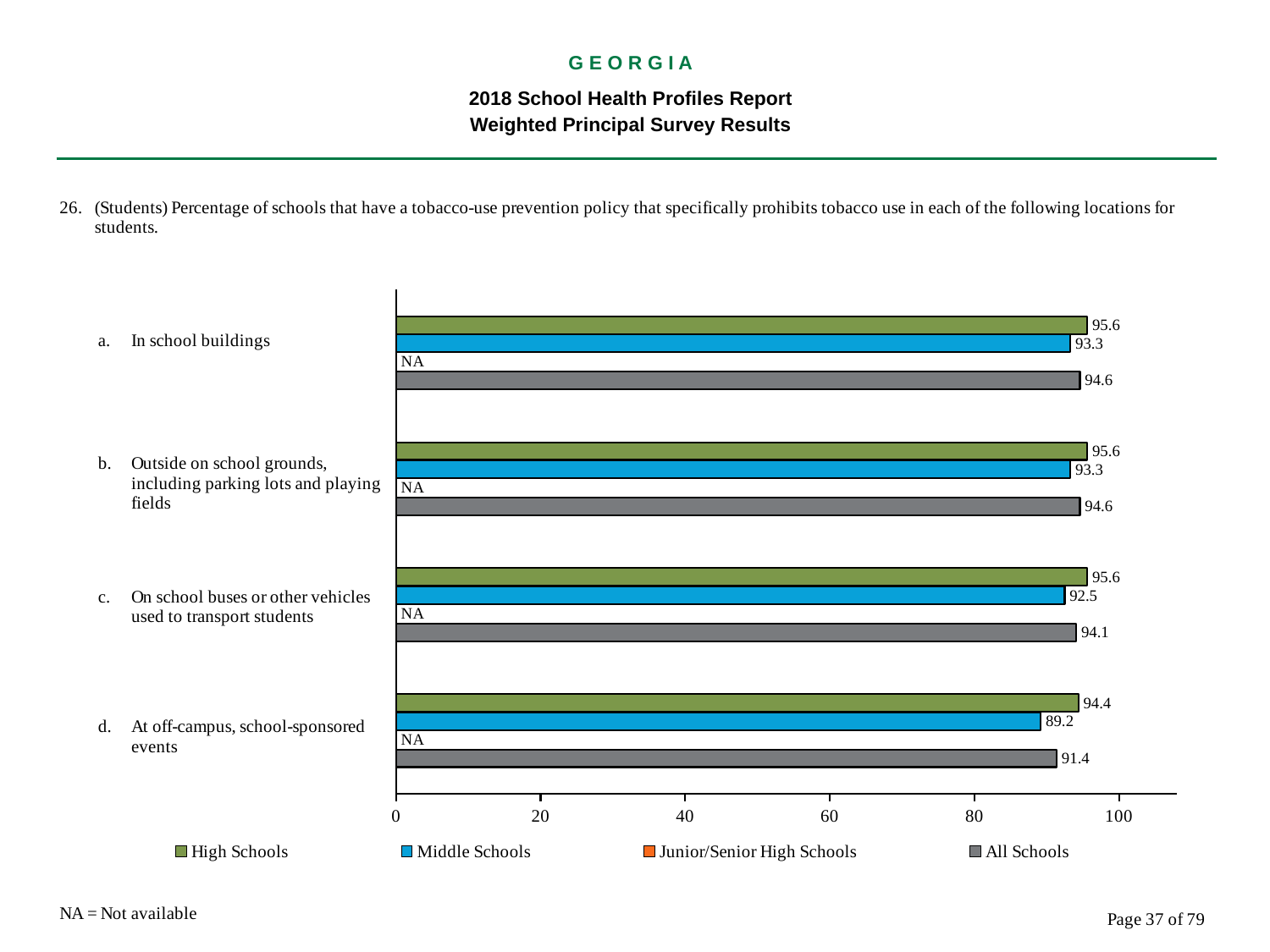
What is the difference between the High Schools and Middle Schools values for 'At off-campus, school-sponsored events'? 5.2 Which is larger for 'On school buses or other vehicles used to transport students': the High Schools value or the Middle Schools value? High Schools What is the value for All Schools for 'On school buses or other vehicles used to transport students'? 94.1 What kind of chart is shown on the slide? Bar chart What value is shown for Junior/Senior High Schools for 'In school buildings'? NA What is the value for Middle Schools for 'At off-campus, school-sponsored events'? 89.2 Is the Middle Schools value for 'At off-campus, school-sponsored events' greater or less than 80? greater How many location categories are shown on the chart? 4 What is the difference between the All Schools values for 'In school buildings' and 'At off-campus, school-sponsored events'? 3.2 How many series does the legend list? 4 Which location has the lowest value for Middle Schools? At off-campus, school-sponsored events What is the value for High Schools for 'In school buildings'? 95.6